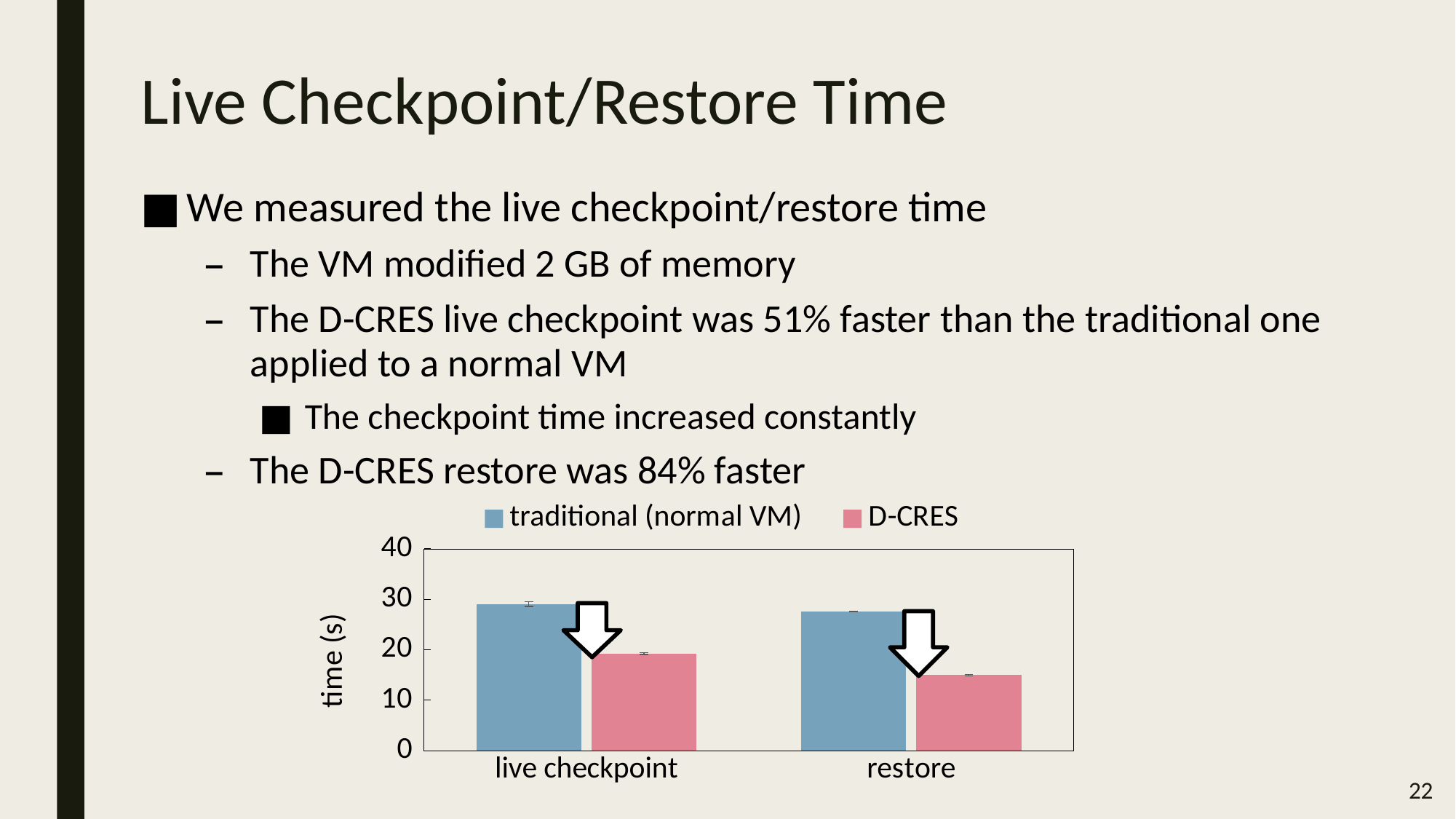
How many series does the chart's legend list? 2 Which series is drawn in pink in the chart? D-CRES Is the value for D-CRES restore greater or less than 20? less For live checkpoint, which is larger: traditional (normal VM) or D-CRES? traditional (normal VM) Is the value for D-CRES live checkpoint greater or less than 10? greater Is the value for traditional (normal VM) restore greater or less than 20? greater Which bar in the chart is the lowest? D-CRES restore What is the label of the y axis of the chart? time (s) What kind of chart is shown on the slide? bar chart For restore, which is larger: traditional (normal VM) or D-CRES? traditional (normal VM) How many categories are shown on the x axis of the chart? 2